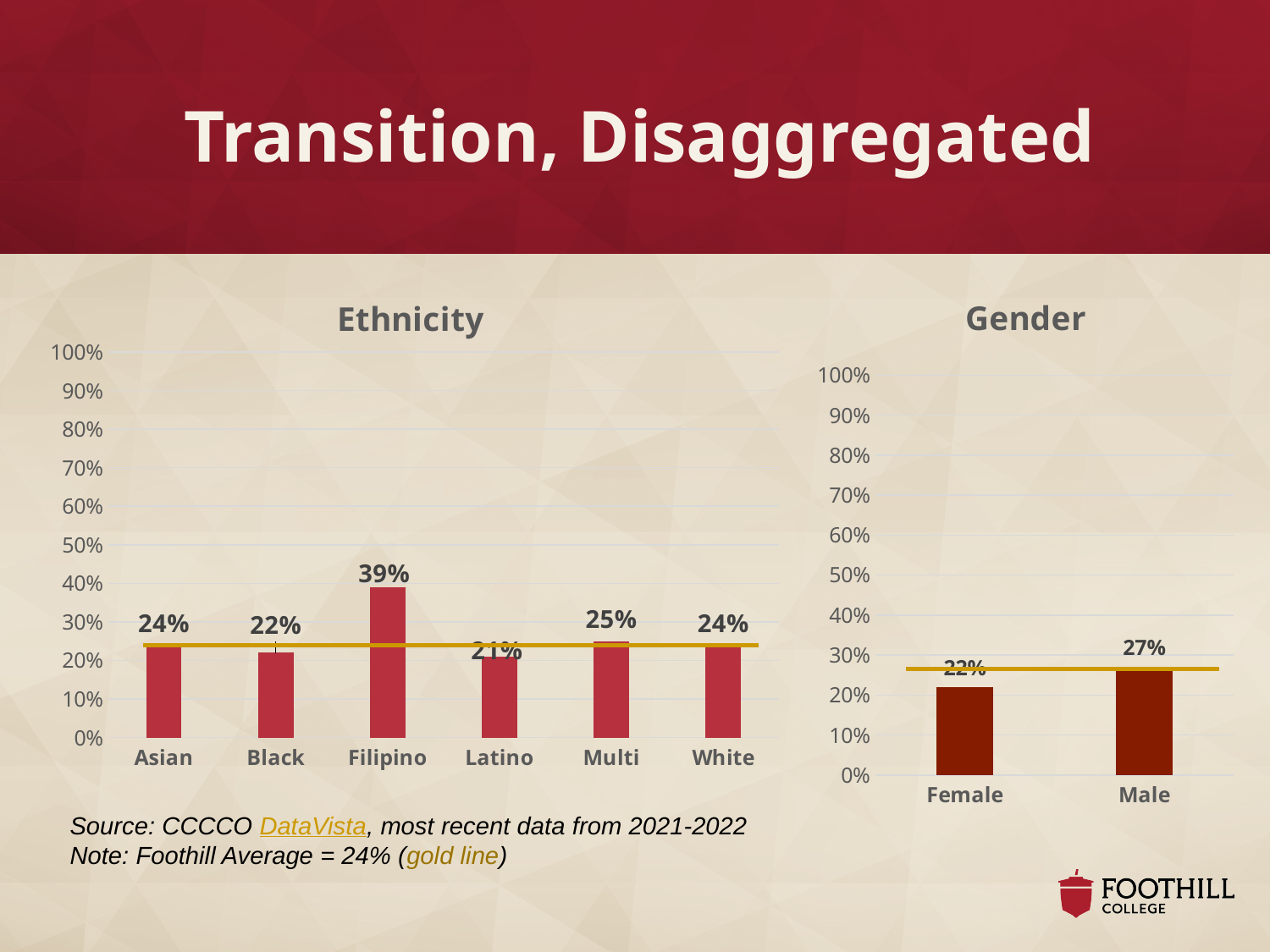
What kind of chart is the Gender chart? bar chart In the Gender chart, what is the value for Male? 27% In the Gender chart, what is the difference between the values for Male and Female? 5% In the Ethnicity chart, is the value for Filipino greater or less than 30%? greater In the Ethnicity chart, which category has the highest value? Filipino In the Ethnicity chart, what is the difference between the values for Filipino and Black? 17% In the Ethnicity chart, which is larger, the value for Multi or the value for Black? Multi In the Ethnicity chart, which category has the lowest value? Latino In the Ethnicity chart, what is the value for Asian? 24% In the Ethnicity chart, what is the value for Filipino? 39% According to the note on the slide, what does the gold line represent? Foothill Average = 24% How many categories are shown in the Ethnicity chart? 6